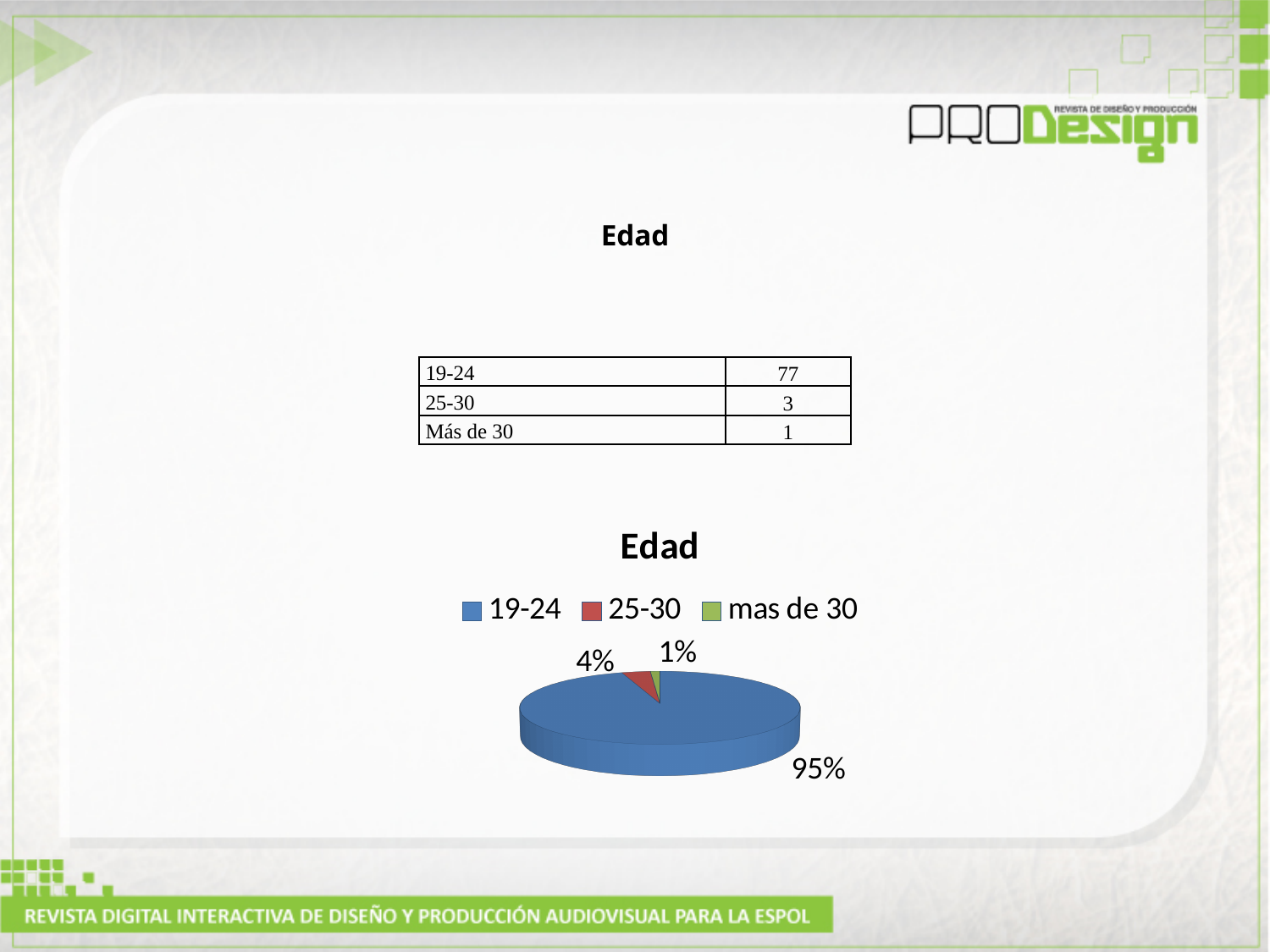
What percentage of the pie does the 19-24 slice represent? 95% What is the title of the chart? Edad What percentage of the pie does the 'mas de 30' slice represent? 1% How many categories does the legend of the pie chart list? 3 Which category has the largest slice of the pie? 19-24 What is the difference in percentage points between the 19-24 slice and the 25-30 slice? 91 What kind of chart is shown on the slide? pie chart What colour is the slice for the 19-24 category? blue How many slices does the pie chart have? 3 Which slice is larger, 25-30 or mas de 30? 25-30 What percentage of the pie does the 25-30 slice represent? 4% Which category has the smallest slice of the pie? mas de 30